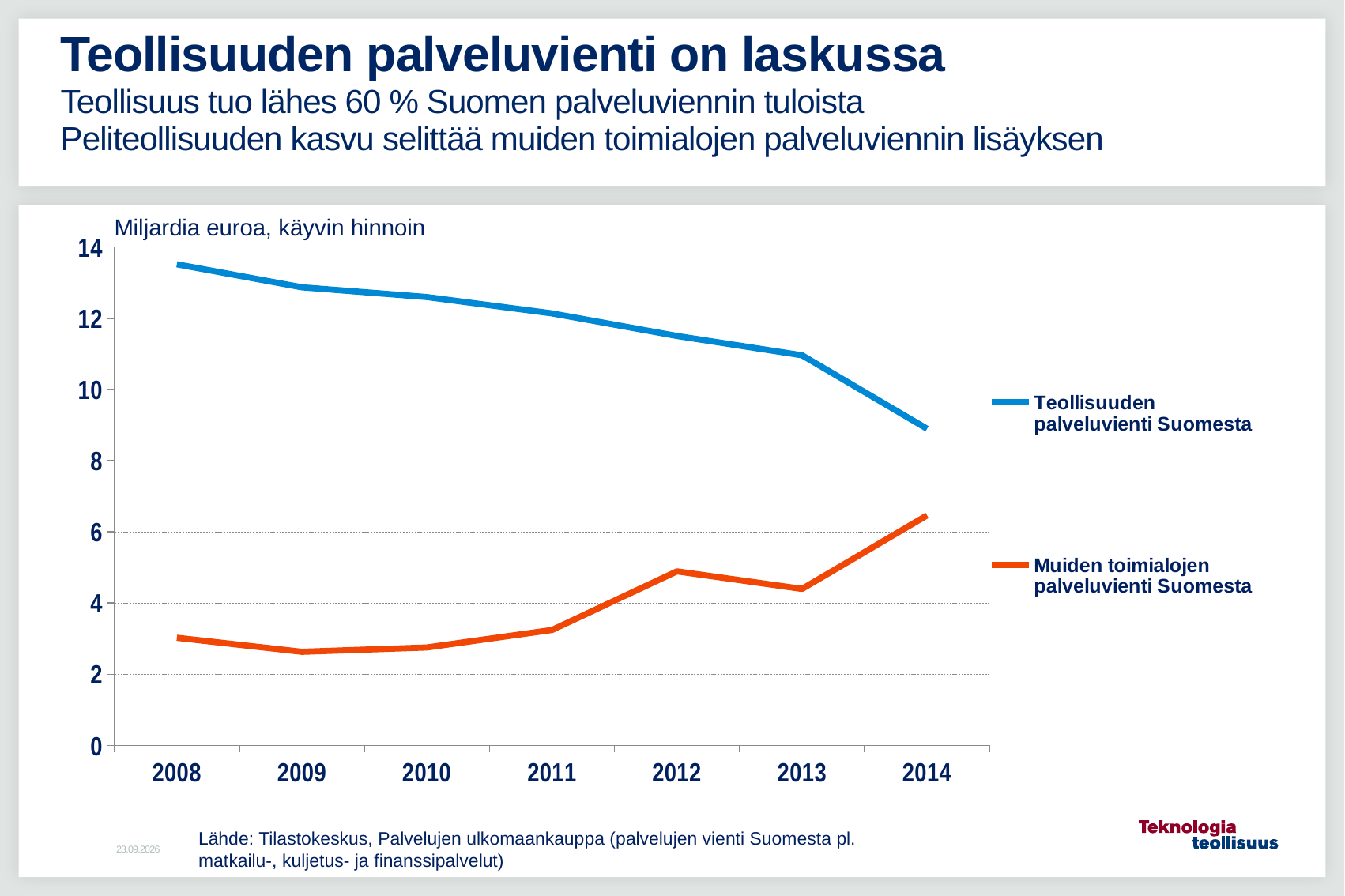
In which year is Teollisuuden palveluvienti Suomesta highest? 2008 How many years are shown on the x axis? 7 Is the value for Teollisuuden palveluvienti Suomesta in 2014 greater or less than 10? less Does the line for Muiden toimialojen palveluvienti Suomesta rise or fall from 2009 to 2014? rise What kind of chart is shown on the slide? line chart In which year is Teollisuuden palveluvienti Suomesta lowest? 2014 What unit is given above the y axis of the chart? Miljardia euroa, käyvin hinnoin Does the line for Teollisuuden palveluvienti Suomesta rise or fall from 2008 to 2014? fall How many series does the legend list? 2 In 2014, which series has the larger value: Teollisuuden palveluvienti Suomesta or Muiden toimialojen palveluvienti Suomesta? Teollisuuden palveluvienti Suomesta Is the value for Muiden toimialojen palveluvienti Suomesta in 2014 greater or less than 6? greater In which year is Muiden toimialojen palveluvienti Suomesta highest? 2014